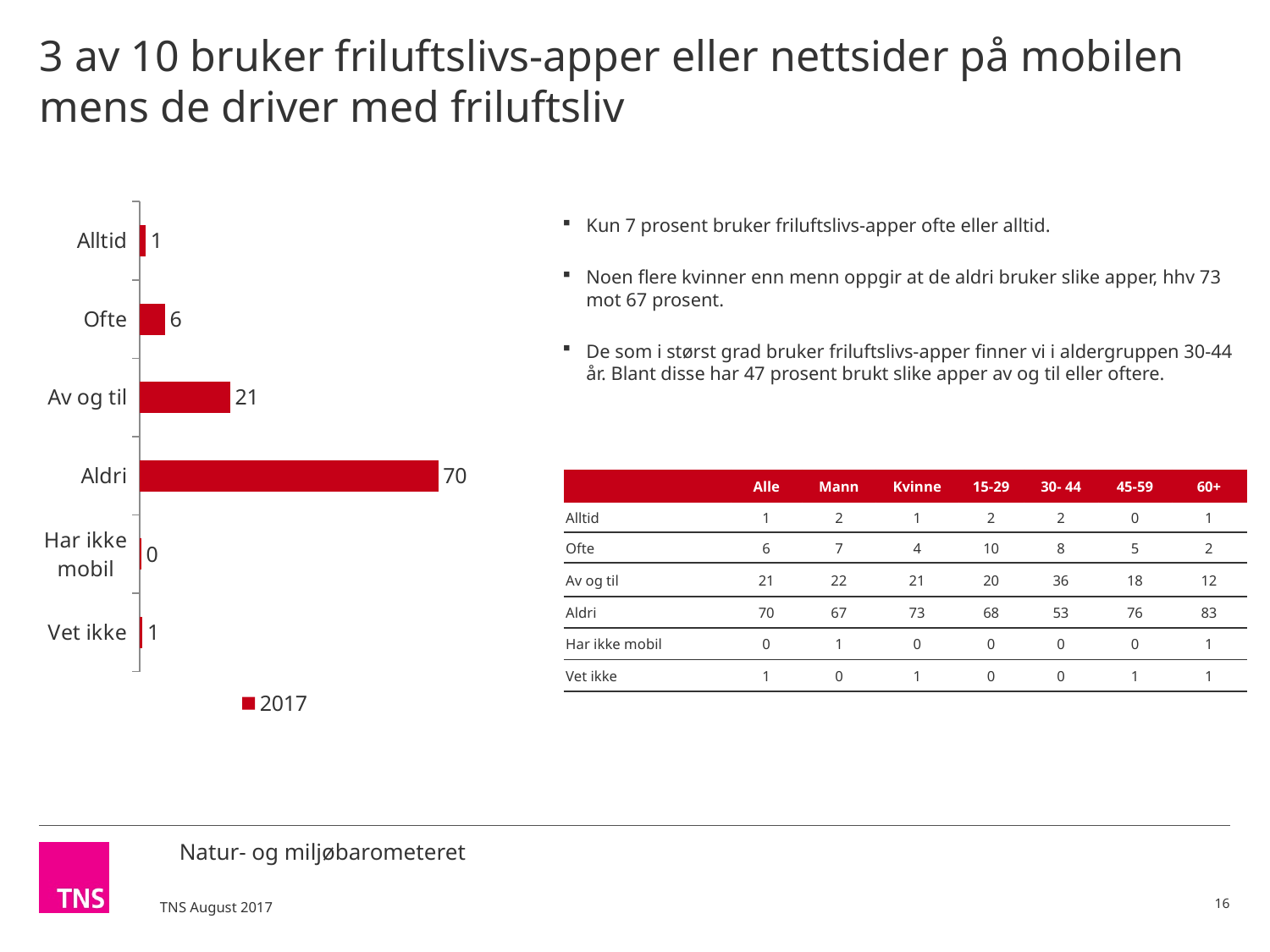
What is the value for Av og til in the bar chart? 21 What is the value for Har ikke mobil in the bar chart? 0 How many series does the legend of the bar chart list? 1 What is the value for Ofte in the bar chart? 6 What is the value for Aldri in the bar chart? 70 How many categories are shown in the bar chart? 6 What kind of chart is shown on the slide? Bar chart Which category has the highest value in the bar chart? Aldri What series name is shown in the legend of the bar chart? 2017 Which category has the lowest value in the bar chart? Har ikke mobil What is the difference between the values for Aldri and Av og til in the bar chart? 49 Which is larger in the bar chart, the value for Ofte or the value for Av og til? Av og til